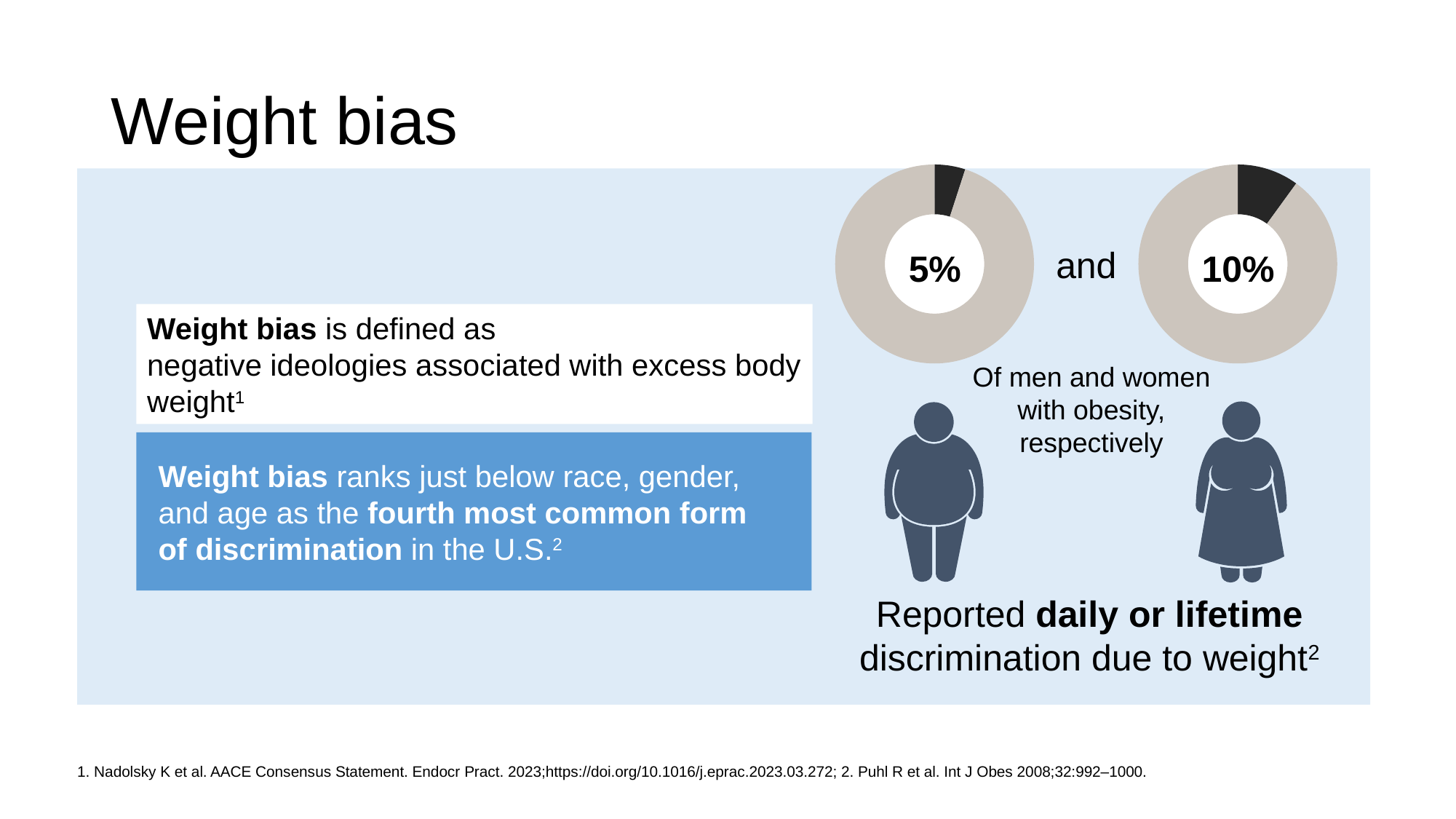
What percentage is shown in the left donut chart, for men with obesity who reported daily or lifetime discrimination due to weight? 5% Is the value in the right donut chart (women) greater or less than the value in the left donut chart (men)? greater What do the two donut charts represent, according to the text beneath them? Men and women with obesity who reported daily or lifetime discrimination due to weight What colour is used for the highlighted (5% and 10%) segment in the donut charts? Dark grey/black Which group shows the lower percentage reporting daily or lifetime discrimination due to weight, men or women? Men What percentage is shown in the right donut chart, for women with obesity who reported daily or lifetime discrimination due to weight? 10% Which group shows the higher percentage reporting daily or lifetime discrimination due to weight, men or women? Women What is the difference between the percentage for women (right chart) and the percentage for men (left chart)? 5% What kind of chart is used to show the 5% and 10% figures on the slide? Donut (pie) chart How many donut charts are shown on the slide? 2 In the left donut chart, what share of the ring is shown in the dark colour? 5% In the right donut chart, what share of the ring is shown in the dark colour? 10%